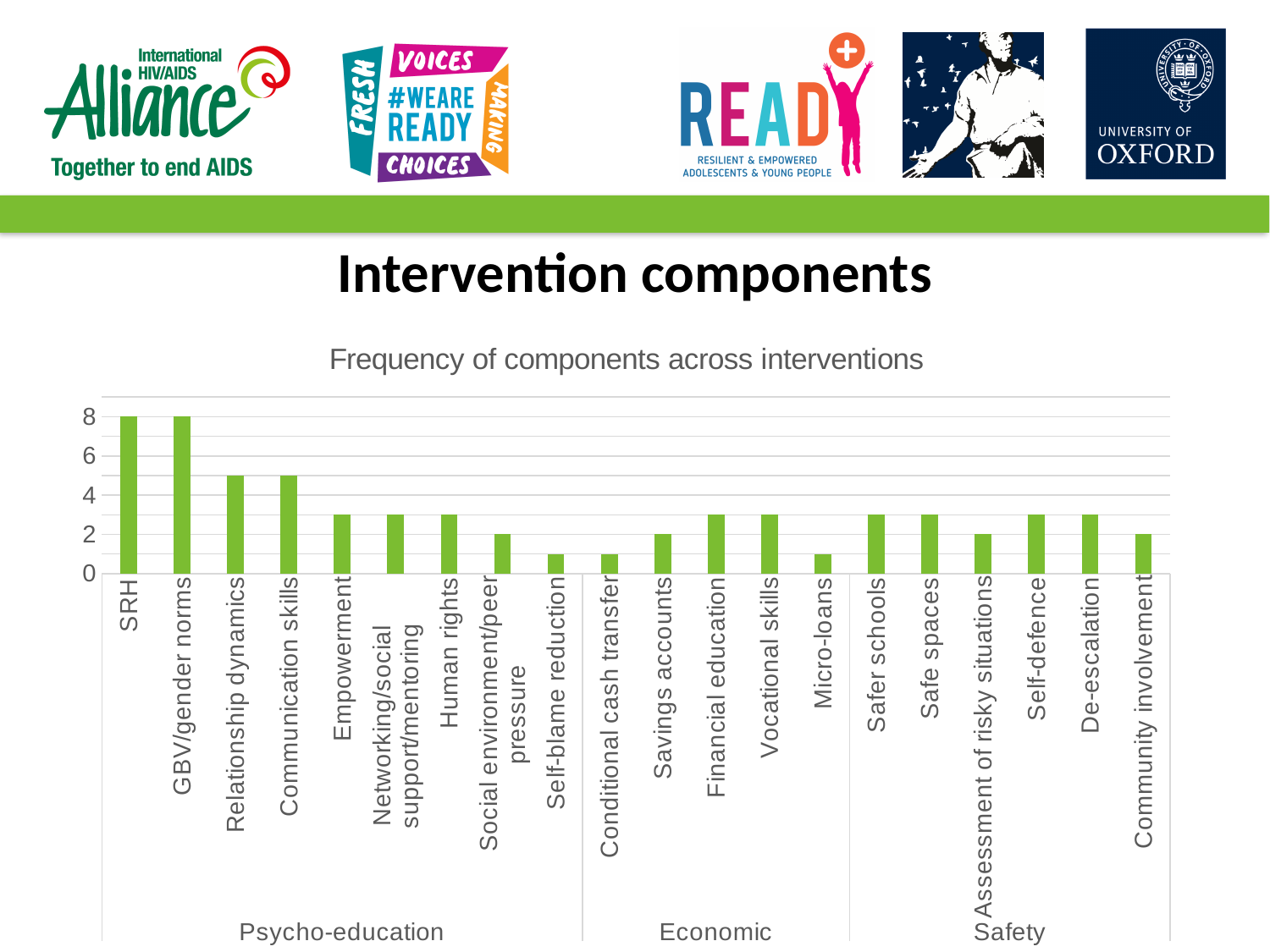
Is the value for Relationship dynamics greater or less than 4? greater Is the value for Self-blame reduction greater or less than 2? less Which is larger, the value for Relationship dynamics or the value for Empowerment? Relationship dynamics What is the title of the chart? Frequency of components across interventions What kind of chart is shown on the slide? bar chart What is the value for Community involvement? 2 Is the value for Empowerment greater or less than 4? less What are the three group labels shown along the bottom of the chart? Psycho-education, Economic, Safety What is the value for SRH? 8 What is the value for Savings accounts? 2 How many component categories are plotted on the chart? 20 What is the difference between the value for SRH and the value for Savings accounts? 6